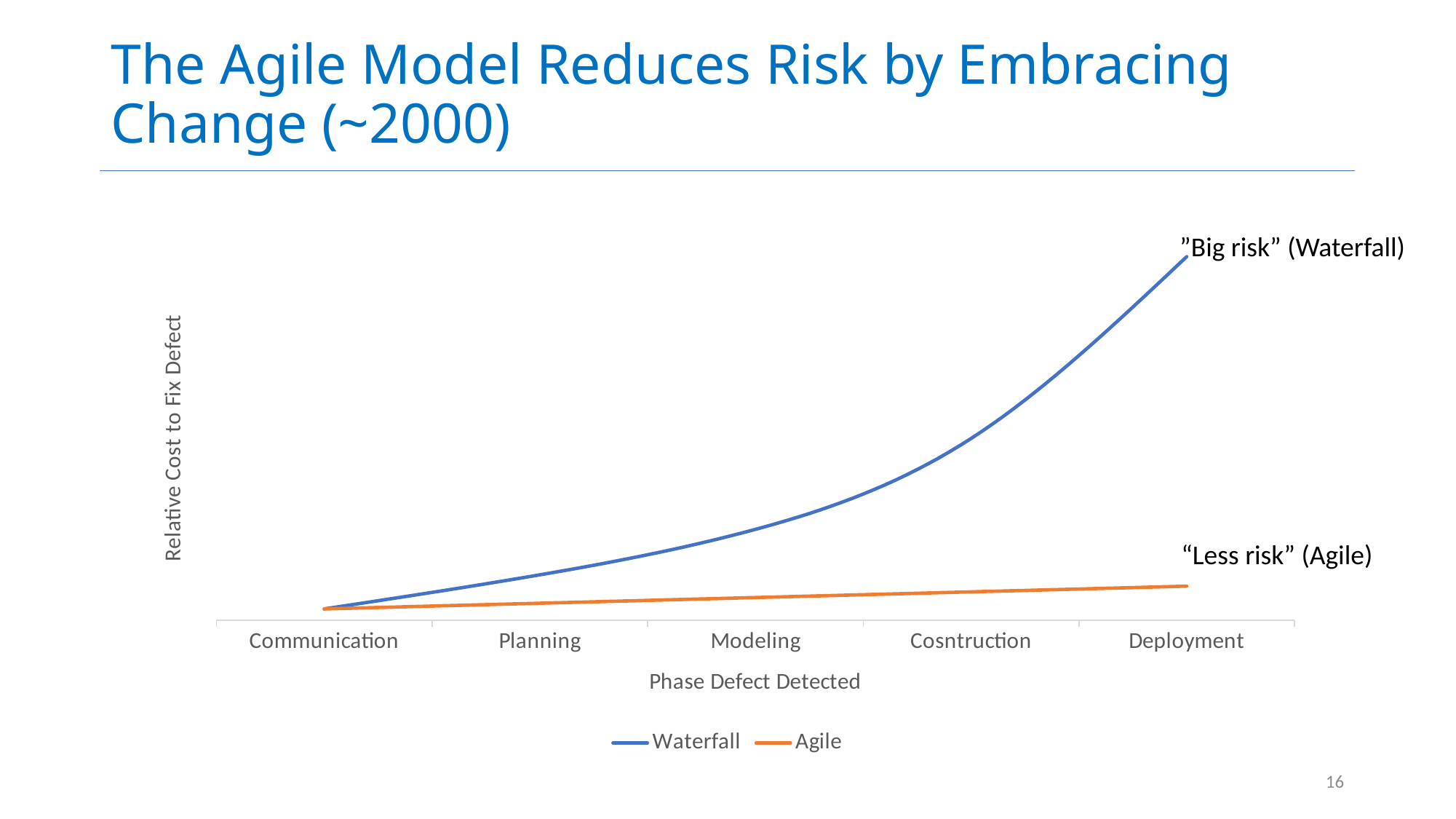
Which phase comes immediately after Modeling on the x axis? Cosntruction In which phase is the Waterfall relative cost to fix a defect highest? Deployment What is the title of the x axis? Phase Defect Detected Which series is labelled "Big risk" on the chart? Waterfall How many phases are shown along the x axis? 5 Does the Agile line rise or fall from Communication to Deployment? rise How many series does the legend list? 2 In which phase is the Waterfall relative cost to fix a defect lowest? Communication At the Deployment phase, which series has the higher relative cost to fix a defect, Waterfall or Agile? Waterfall Which series rises more steeply across the phases, Waterfall or Agile? Waterfall Does the Waterfall line rise or fall from Communication to Deployment? rise What kind of chart is shown on the slide? line chart